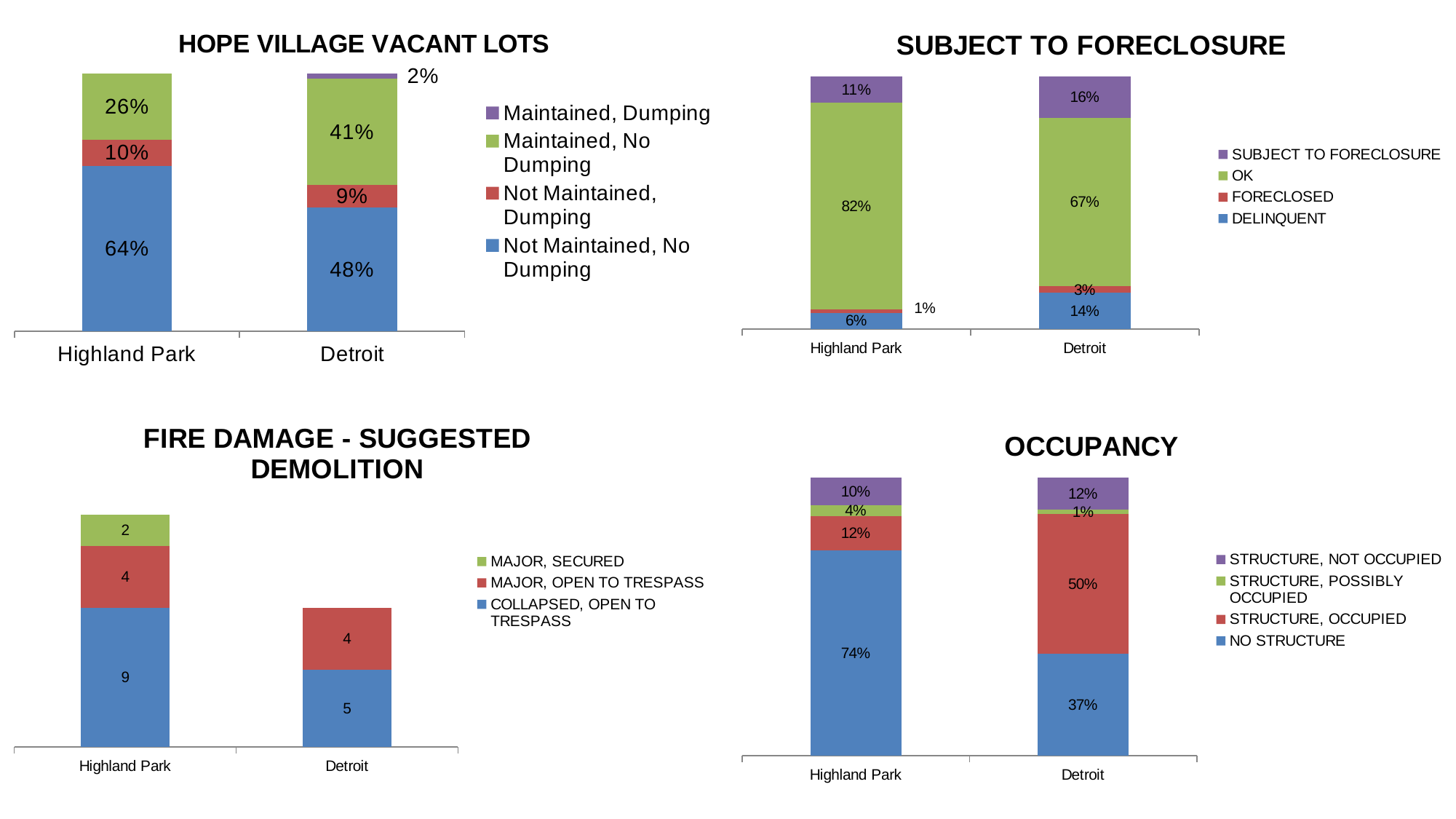
In the HOPE VILLAGE VACANT LOTS chart, what is the difference between the Maintained, No Dumping share for Detroit and for Highland Park? 15% In the OCCUPANCY chart, what is the difference between the NO STRUCTURE share for Highland Park and for Detroit? 37% How many series does the legend of the SUBJECT TO FORECLOSURE chart list? 4 In the FIRE DAMAGE - SUGGESTED DEMOLITION chart, what is the total of the Detroit stacked bar? 9 In the HOPE VILLAGE VACANT LOTS chart, what percentage of Highland Park lots are Not Maintained, No Dumping? 64% In the FIRE DAMAGE - SUGGESTED DEMOLITION chart, what is the value for COLLAPSED, OPEN TO TRESPASS in Highland Park? 9 In the OCCUPANCY chart, what percentage of Detroit is STRUCTURE, OCCUPIED? 50% In the SUBJECT TO FORECLOSURE chart, which category has the larger OK share, Highland Park or Detroit? Highland Park In the FIRE DAMAGE - SUGGESTED DEMOLITION chart, what is the total of the Highland Park stacked bar? 15 In the SUBJECT TO FORECLOSURE chart, what percentage of Detroit is DELINQUENT? 14% What kind of chart is the OCCUPANCY chart? Stacked bar chart In the HOPE VILLAGE VACANT LOTS chart, what percentage of Detroit lots are Maintained, Dumping? 2%